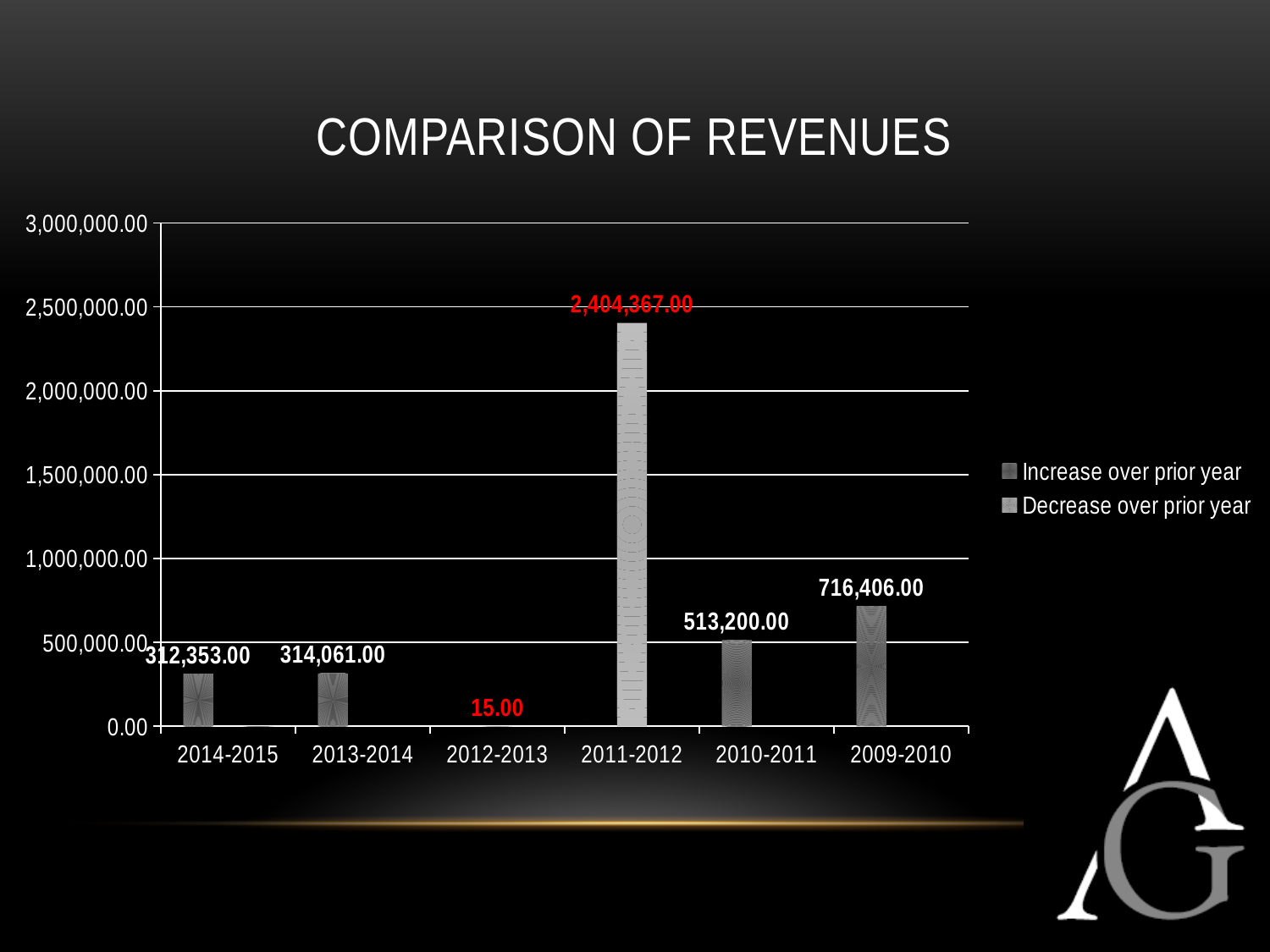
What is the value shown for 2012-2013? 15.00 Which year has the lowest value? 2012-2013 How many year categories are shown on the x axis? 6 Which year has the highest value? 2011-2012 What is the difference between the values for 2009-2010 and 2010-2011? 203,206.00 How many series does the legend list? 2 What is the value shown for 2011-2012? 2,404,367.00 What type of chart is shown on the slide? Bar chart What is the value shown for 2009-2010? 716,406.00 Is the value for 2011-2012 greater or less than 2,000,000.00? greater What is the value shown for 2014-2015? 312,353.00 Which is larger, the value for 2010-2011 or the value for 2014-2015? 2010-2011